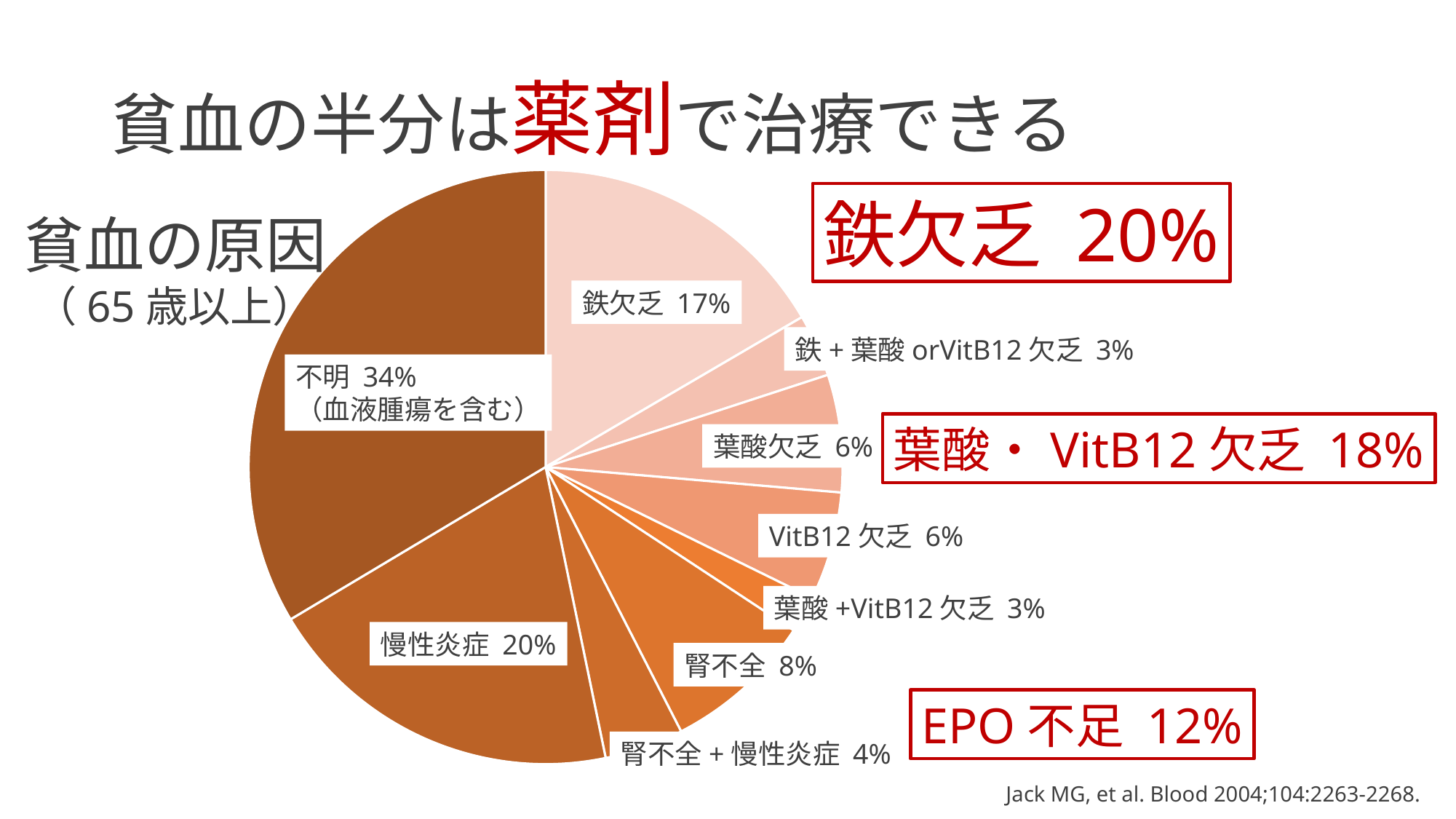
Which slice of the pie is the largest? 不明（血液腫瘍を含む） What percentage of the pie is labelled 鉄欠乏? 17% What percentage is shown in the red box labelled EPO不足? 12% What is the combined share of 葉酸欠乏 and VitB12欠乏? 12% What is the title of the pie chart? 貧血の原因（65歳以上） What percentage is shown for 腎不全＋慢性炎症? 4% How many slices does the pie chart have? 9 What is the difference in percentage points between 不明 and 慢性炎症? 14 What kind of chart is shown on the slide? pie chart What percentage is shown for 腎不全? 8% Which is larger, the slice for 葉酸欠乏 or the slice for 腎不全? 腎不全 What percentage is shown for 慢性炎症? 20%